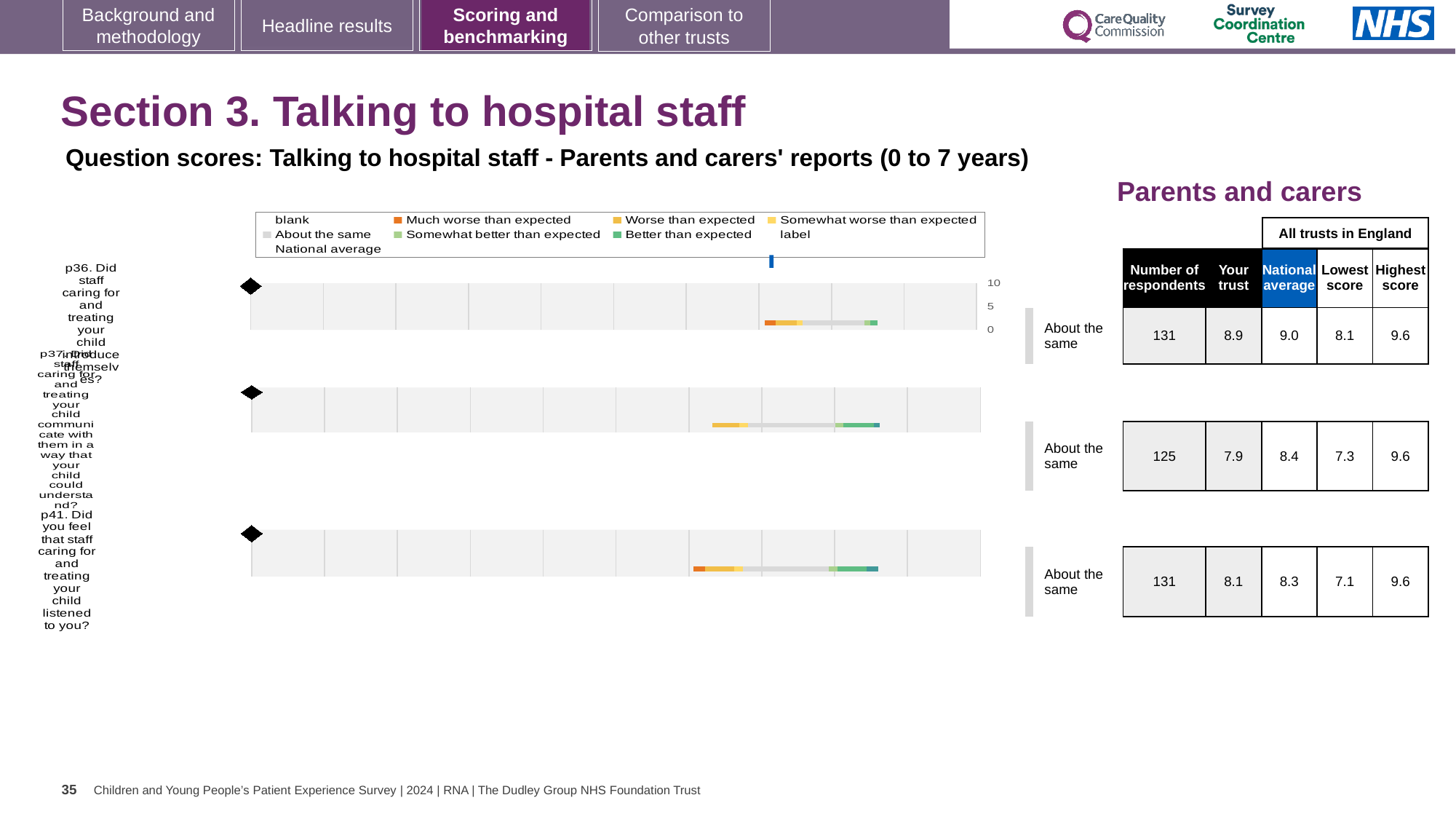
How many benchmark charts are shown on the slide? 3 What is the 'Your trust' score for p41 (Did you feel that staff caring for and treating your child listened to you?)? 8.1 What is the 'Your trust' score for p36 (Did staff caring for and treating your child introduce themselves?)? 8.9 Which of the three questions has the highest 'Your trust' score? p36 What is the difference between the national average and the 'Your trust' score for p37? 0.5 What is the highest score across all trusts in England for p36? 9.6 For p41, which is larger: the 'Your trust' score or the national average? National average How many respondents answered p37? 125 What is the national average score for p37 (Did staff communicate with your child in a way they could understand?)? 8.4 What benchmark category is shown next to each of the three charts? About the same What is the maximum value shown on the chart axis? 10 Which of the three questions has the lowest 'Your trust' score? p37